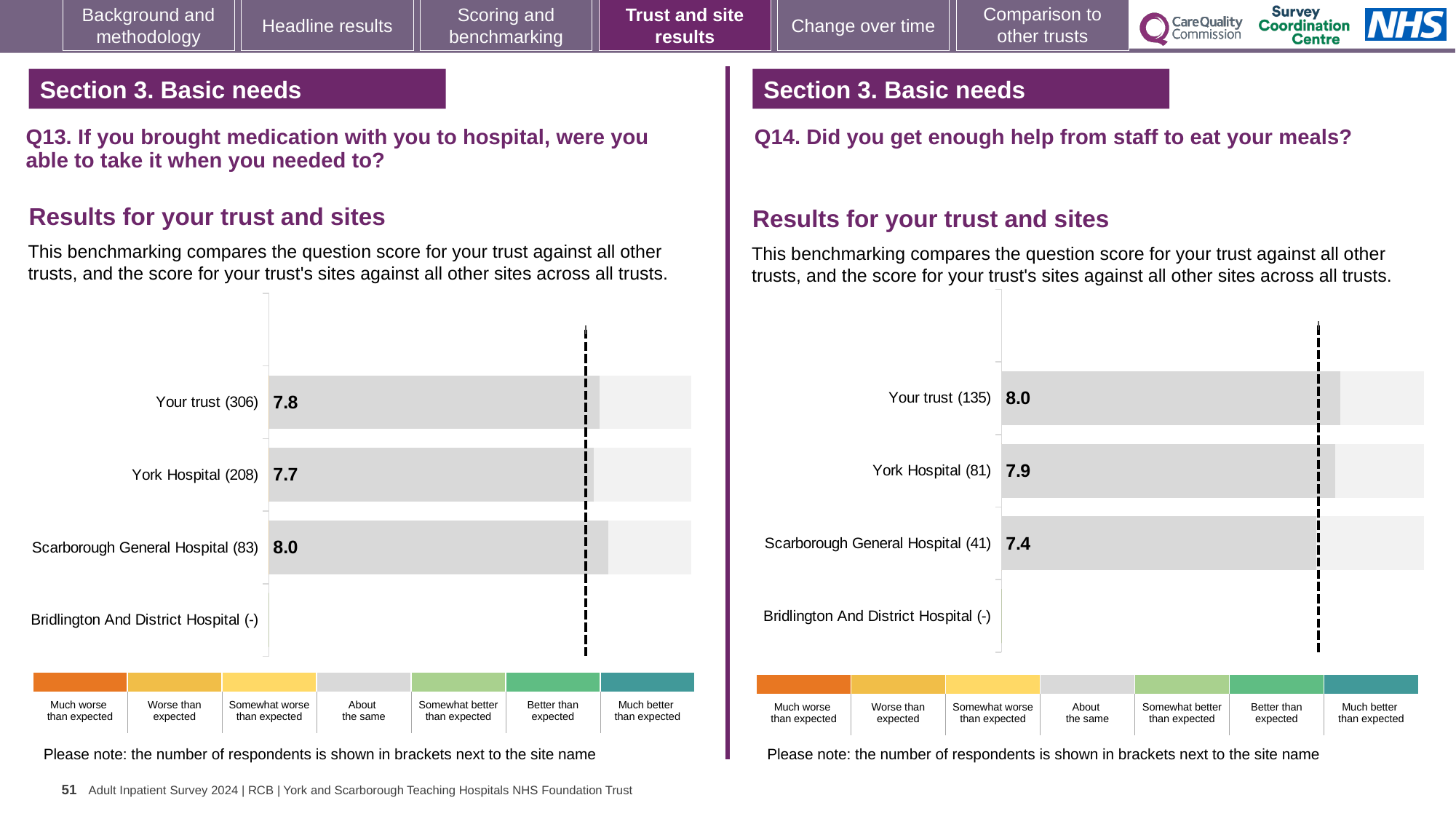
In the Q14 chart on the right, which site has the lowest score? Scarborough General Hospital What kind of chart is used in the Q13 chart on the left? Bar chart In the Q13 chart on the left, which site has the highest score? Scarborough General Hospital In the Q13 chart on the left, what is the difference between the scores for Scarborough General Hospital and York Hospital? 0.3 In the Q14 chart on the right, how many respondents are shown in brackets for York Hospital? 81 In the Q13 chart on the left, how many respondents are shown in brackets for Your trust? 306 In the Q14 chart on the right, what is the score for York Hospital? 7.9 In the Q14 chart on the right, what is the score for Scarborough General Hospital? 7.4 In the Q14 chart on the right, which is larger, the score for Your trust or the score for York Hospital? Your trust In the Q14 chart on the right, what is the difference between the scores for Your trust and Scarborough General Hospital? 0.6 In the Q13 chart on the left, what is the score for Your trust? 7.8 In the Q13 chart on the left, what is the score for Scarborough General Hospital? 8.0